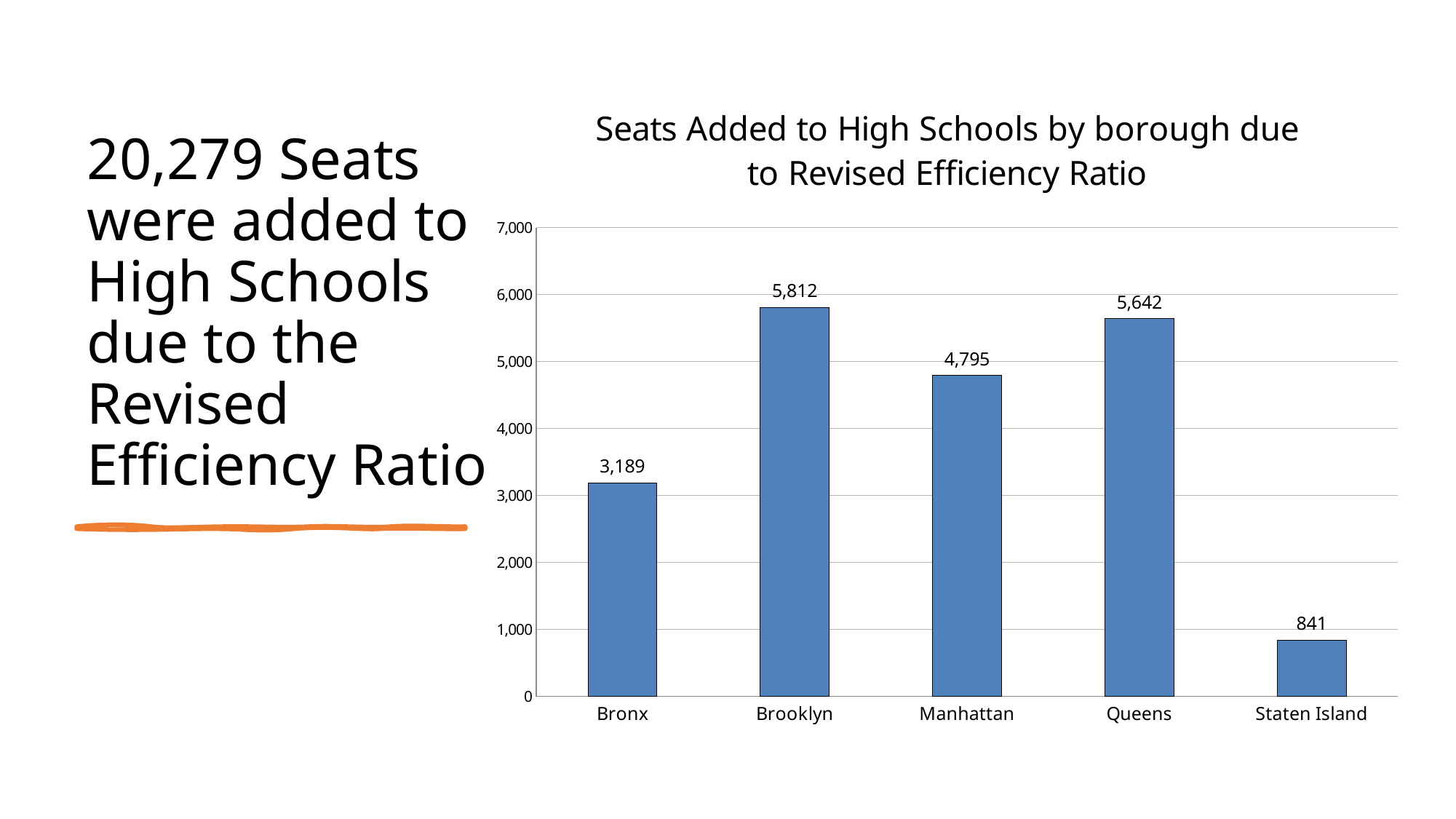
Is the value for Bronx greater or less than 3,000? greater Which borough has the lowest number of seats added? Staten Island How many seats were added to high schools in Brooklyn? 5,812 What is the title of the chart? Seats Added to High Schools by borough due to Revised Efficiency Ratio What is the difference between the seats added in Brooklyn and Queens? 170 What is the difference between the seats added in Bronx and Staten Island? 2,348 How many boroughs are shown on the chart? 5 What is the value shown for Staten Island? 841 Which borough has the highest number of seats added? Brooklyn Which has more seats added, Manhattan or Queens? Queens How many seats were added in Manhattan? 4,795 What type of chart is shown on the slide? Bar chart